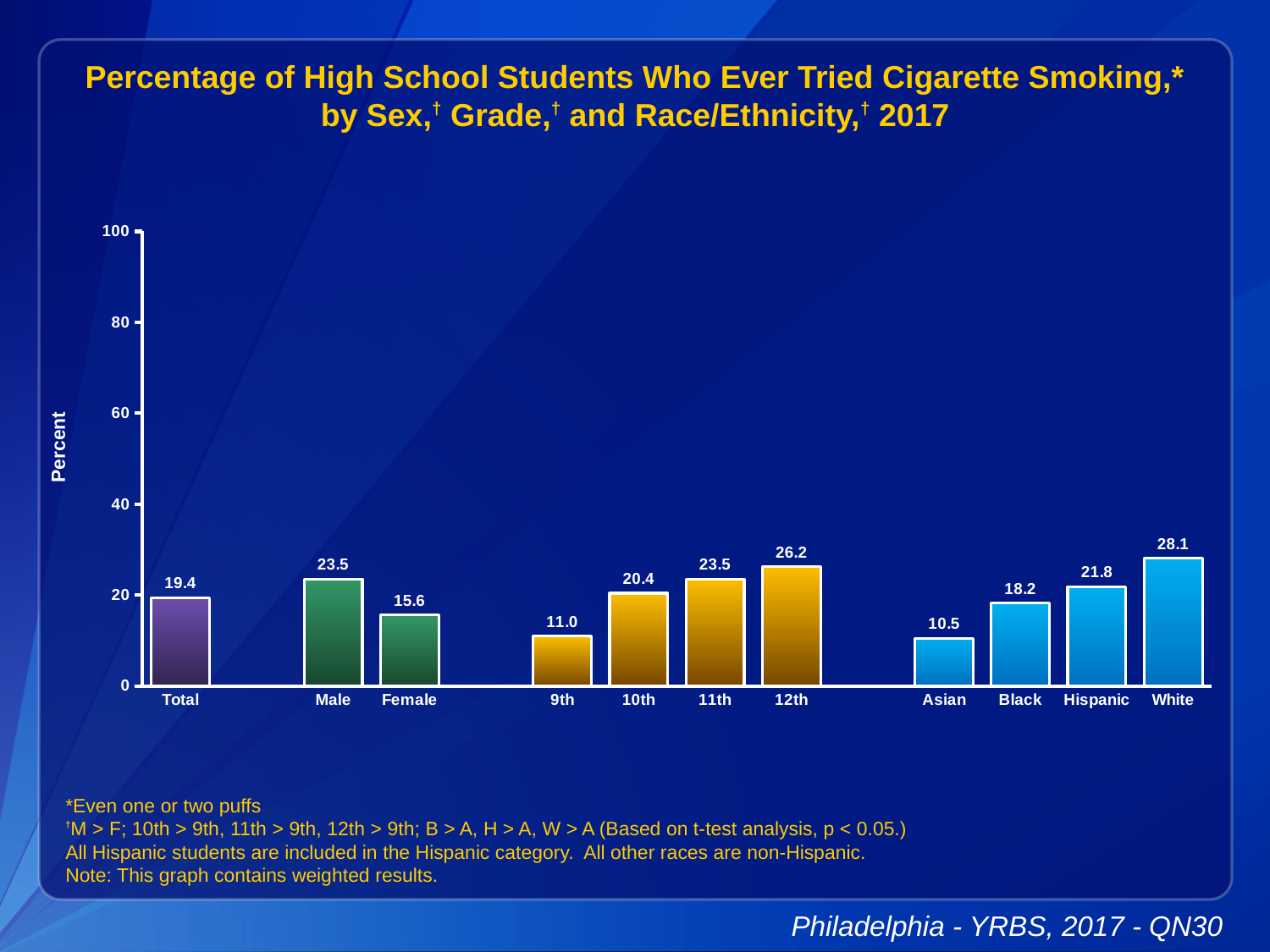
What is the value for 9th grade? 11.0 Which category has the lowest value on the chart? Asian What is the value for Total? 19.4 Which is larger, the value for 12th grade or the value for Hispanic? 12th Which category has the highest value on the chart? White What kind of chart is shown on the slide? bar chart How many bars are shown on the chart? 11 What percentage of female students ever tried cigarette smoking? 15.6 What is the label of the y axis? Percent What is the difference between the Male and Female values? 7.9 Is the value for Black greater or less than 20? less Do the values rise or fall from 9th grade to 12th grade? rise